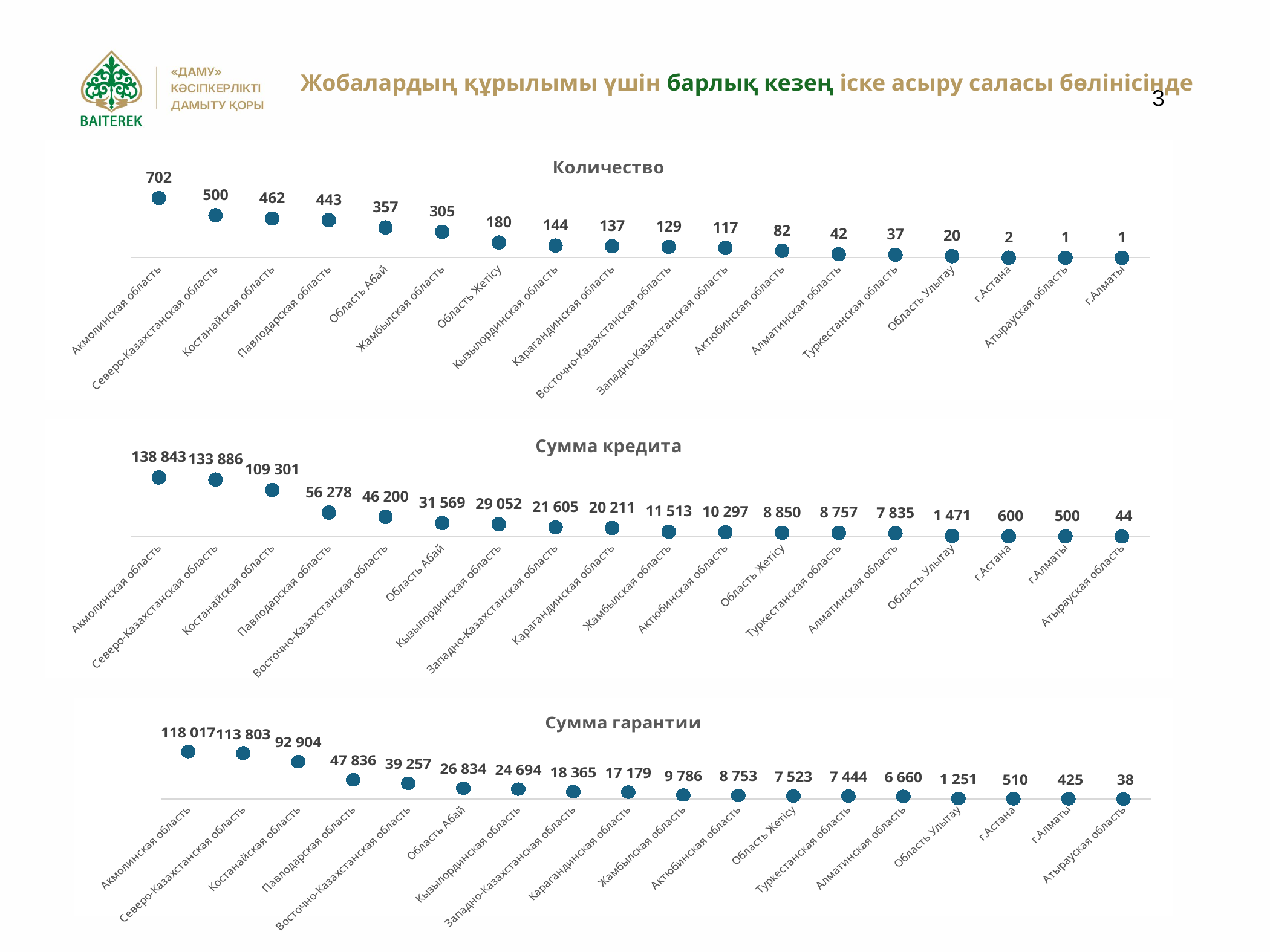
In the "Сумма гарантии" chart, what is the value for Область Абай? 26 834 In the "Количество" chart, which category has the highest value? Акмолинская область In the "Сумма гарантии" chart, what is the value for г.Астана? 510 What kind of chart is the "Сумма гарантии" chart? scatter chart In the "Сумма кредита" chart, what is the value for Костанайская область? 109 301 In the "Сумма кредита" chart, which category has the lowest value? Атырауская область In the "Сумма гарантии" chart, what is the difference between Акмолинская область and Северо-Казахстанская область? 4 214 In the "Количество" chart, what is the difference between Акмолинская область and Северо-Казахстанская область? 202 In the "Сумма кредита" chart, do the values rise or fall from left to right? fall In the "Количество" chart, how many categories are plotted? 18 In the "Сумма кредита" chart, which is larger: Жамбылская область or Актюбинская область? Жамбылская область In the "Количество" chart, what is the value for Павлодарская область? 443